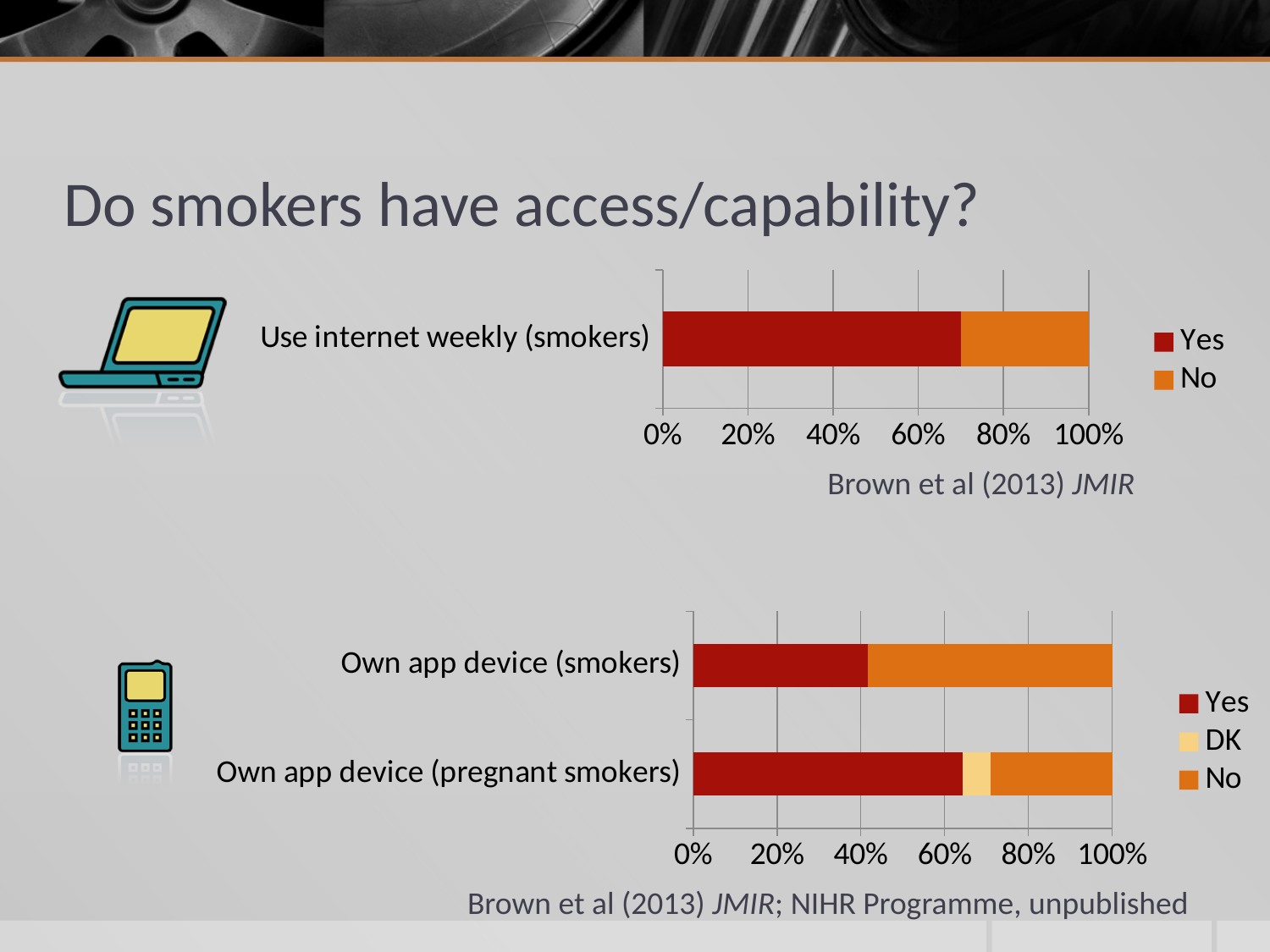
In the bottom chart, which category has the larger 'No' share: 'Own app device (smokers)' or 'Own app device (pregnant smokers)'? Own app device (smokers) In the bottom chart, is the 'Yes' value for 'Own app device (smokers)' greater or less than 60%? less In the bottom chart, is the 'Yes' value for 'Own app device (pregnant smokers)' greater or less than 60%? greater What is the title of the slide containing the two charts? Do smokers have access/capability? In the bottom chart, how many series does the legend list? 3 In the bottom chart, how many categories are plotted? 2 In the top chart, what kind of chart is used to show 'Use internet weekly (smokers)'? bar chart In the top chart, is the 'Yes' value for 'Use internet weekly (smokers)' greater or less than 60%? greater In the bottom chart, which legend entry is shown in the light yellow colour? DK In the top chart, how many series does the legend list? 2 In the bottom chart, which category has the larger 'Yes' share: 'Own app device (smokers)' or 'Own app device (pregnant smokers)'? Own app device (pregnant smokers)